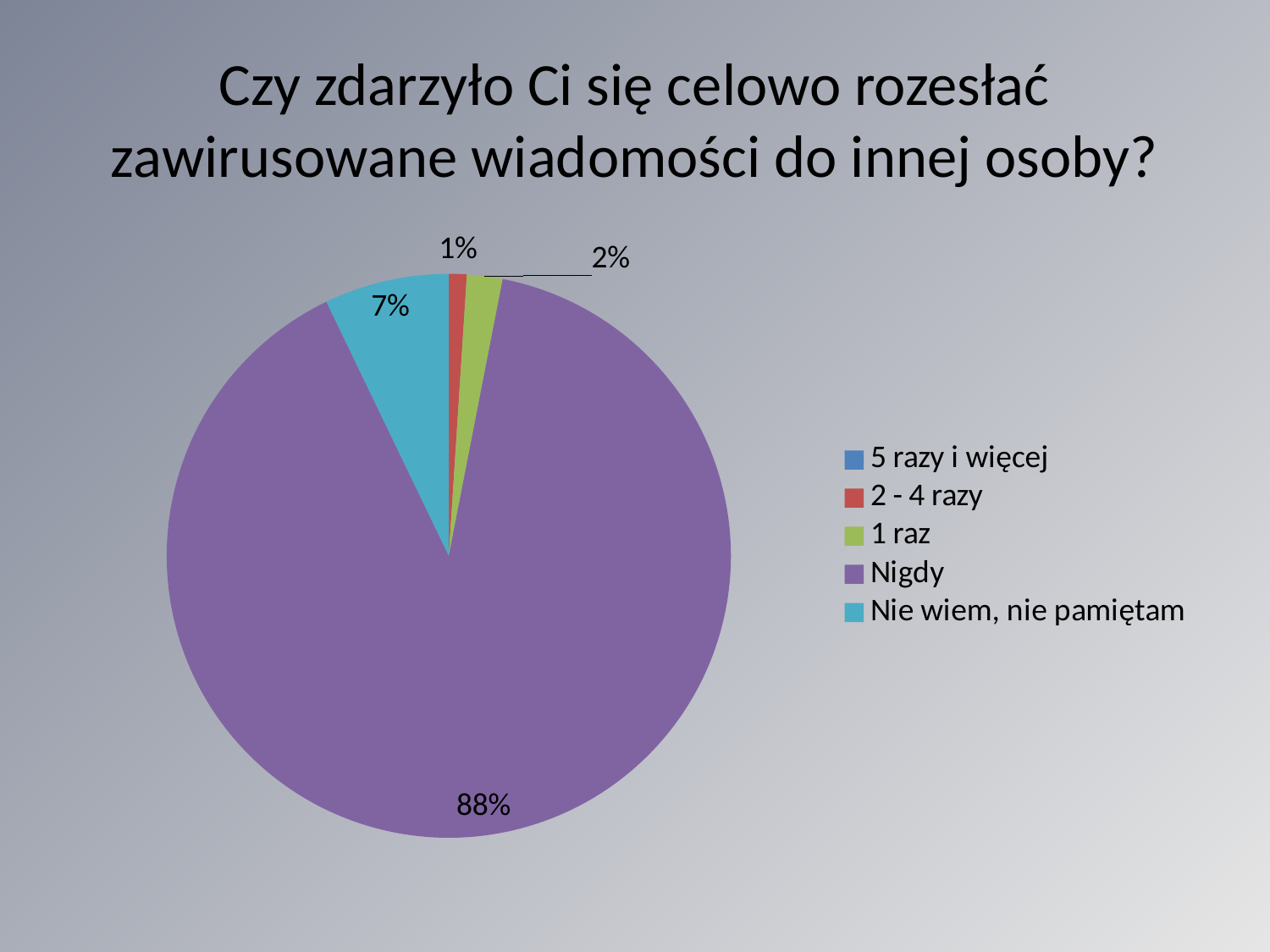
What is the difference in percentage points between "Nigdy" and "Nie wiem, nie pamiętam"? 81% What is the title of the slide? Czy zdarzyło Ci się celowo rozesłać zawirusowane wiadomości do innej osoby? Which category has the largest slice of the pie? Nigdy Which is larger, the slice for "Nigdy" or the slice for "Nie wiem, nie pamiętam"? Nigdy What colour is the slice for "Nigdy"? Purple What percentage is shown for "2 - 4 razy"? 1% What is the difference in percentage points between "Nie wiem, nie pamiętam" and "1 raz"? 5% What percentage of the pie is labelled for "Nigdy"? 88% What percentage is shown for "Nie wiem, nie pamiętam"? 7% What kind of chart is shown on the slide? Pie chart How many entries does the legend list? 5 What percentage is shown for "1 raz"? 2%